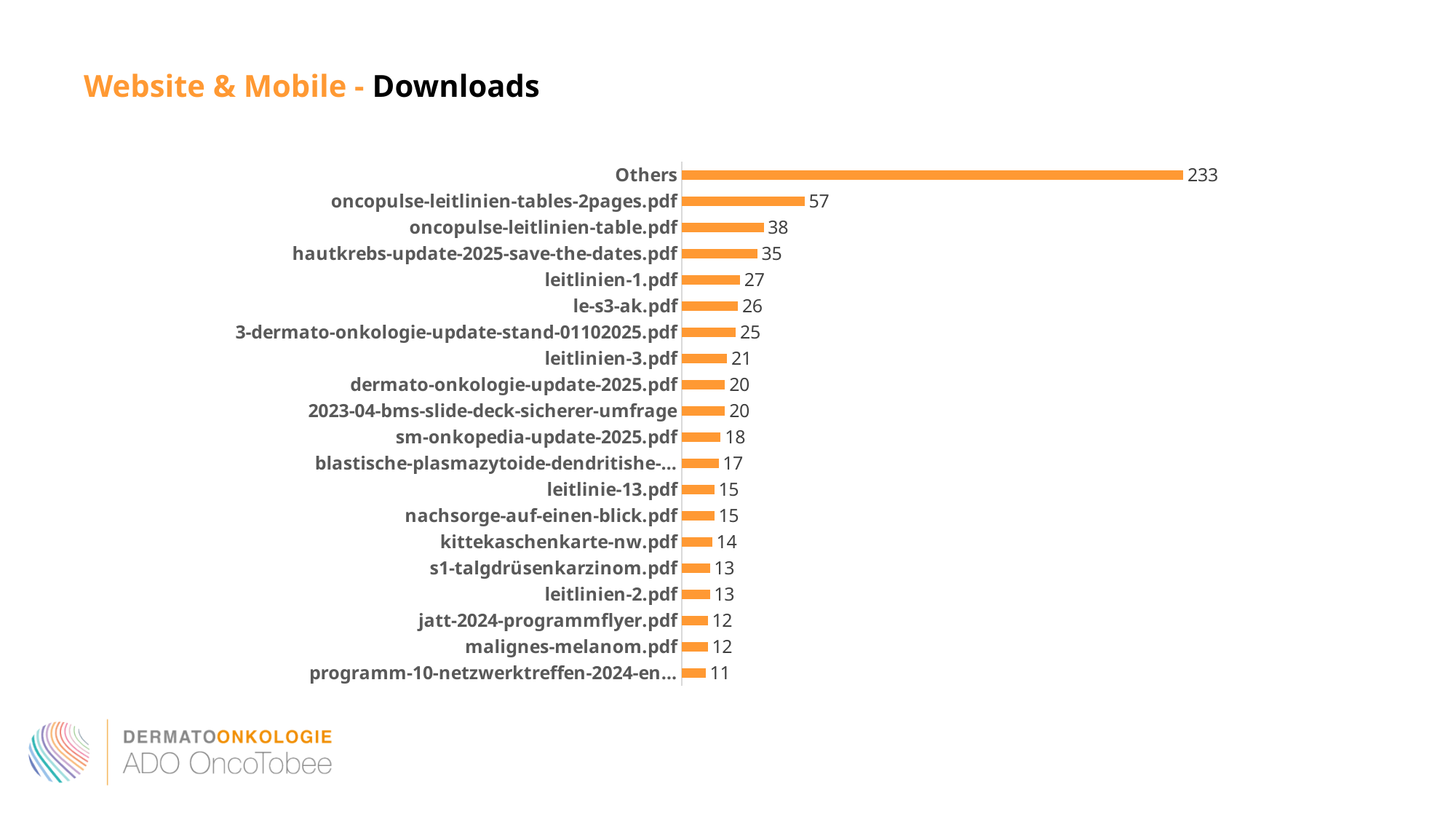
What colour are the bars in the chart? orange How many categories are shown in the chart? 20 Which is larger, the value for leitlinien-1.pdf or the value for le-s3-ak.pdf? leitlinien-1.pdf What is the value for kittekaschenkarte-nw.pdf? 14 What is the value for hautkrebs-update-2025-save-the-dates.pdf? 35 What is the value for Others? 233 What kind of chart is shown on the slide? bar chart Which category has the highest value? Others What is the value for oncopulse-leitlinien-tables-2pages.pdf? 57 What is the difference between the values for oncopulse-leitlinien-tables-2pages.pdf and oncopulse-leitlinien-table.pdf? 19 What is the difference between the values for Others and leitlinien-3.pdf? 212 Which category has the lowest value? programm-10-netzwerktreffen-2024-en...